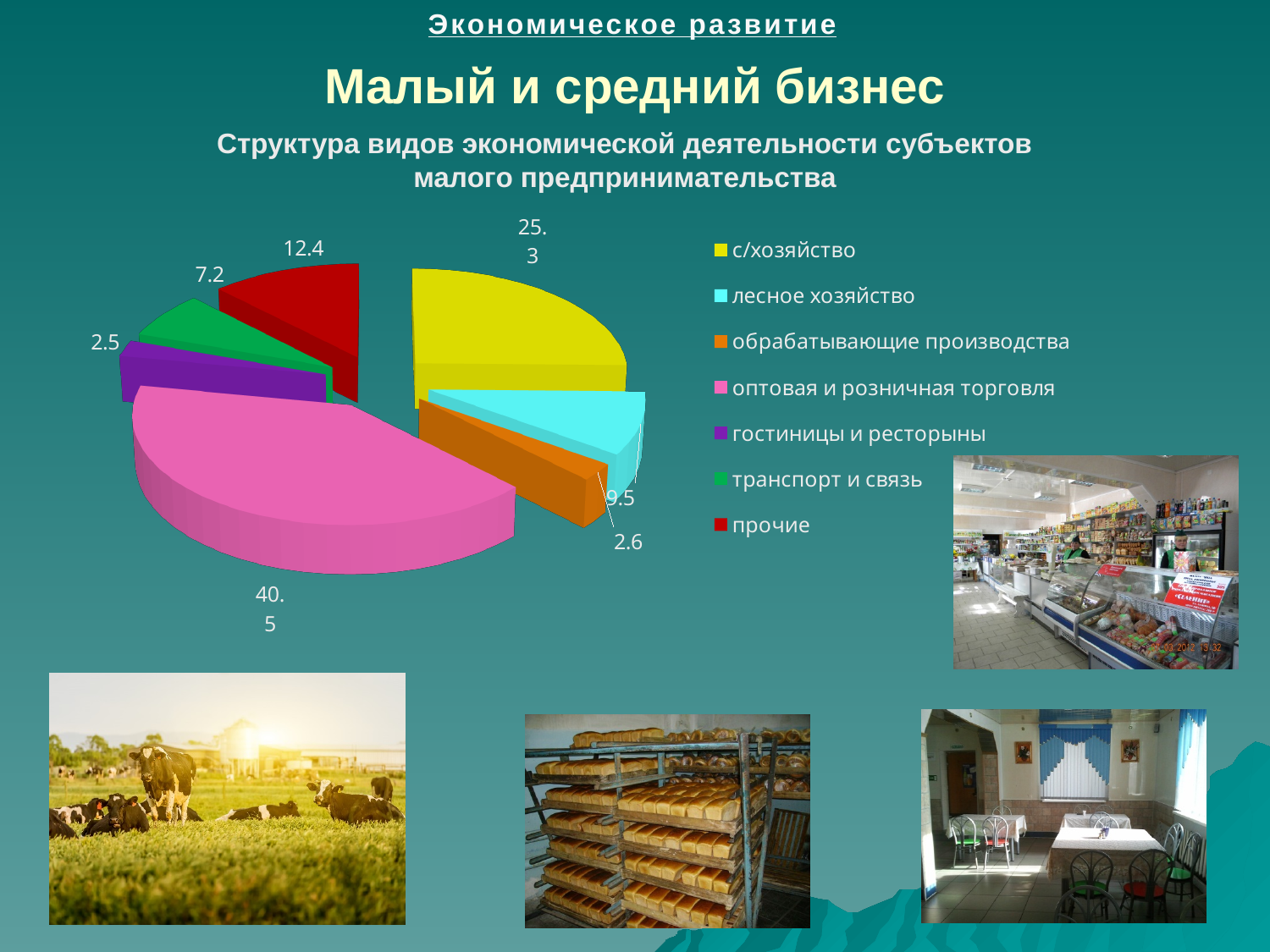
What colour is the slice for обрабатывающие производства? orange What is the value for оптовая и розничная торговля? 40.5 What is the difference between the values for оптовая и розничная торговля and с/хозяйство? 15.2 What type of chart is shown on the slide? pie chart What is the value for транспорт и связь? 7.2 What is the value for лесное хозяйство? 9.5 How many categories does the pie chart show? 7 Which category has the largest slice of the pie? оптовая и розничная торговля What is the value for прочие? 12.4 What is the value for с/хозяйство? 25.3 Which category has the smallest slice of the pie? гостиницы и ресторыны Which is larger, the value for прочие or the value for лесное хозяйство? прочие